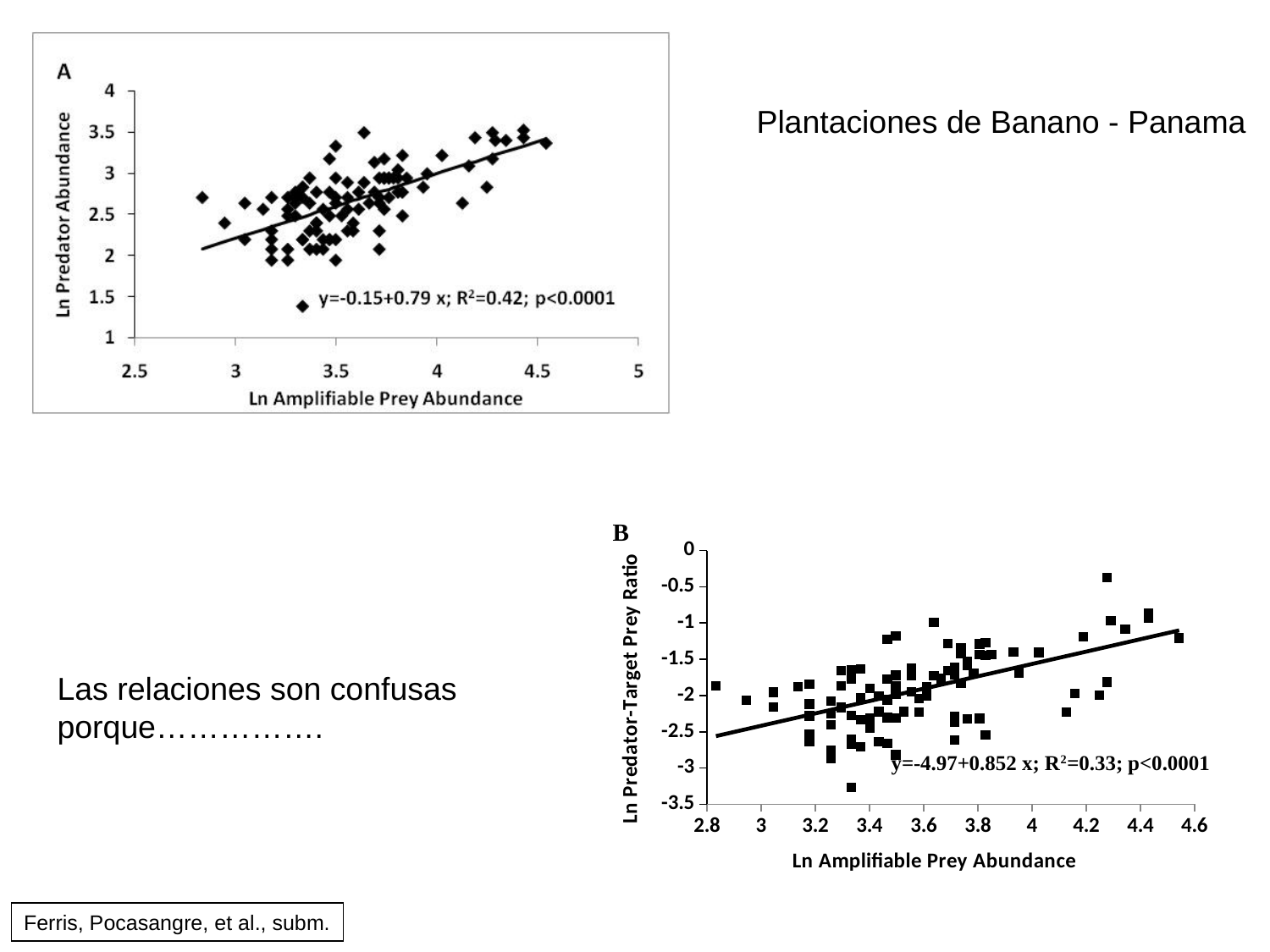
In chart A, is the y value of the lowest plotted point greater or less than 1.5? less What is the y-axis title of chart B? Ln Predator-Target Prey Ratio What kind of chart is chart A (top left)? scatter chart What is the x-axis title of chart A? Ln Amplifiable Prey Abundance In chart A, does Ln Predator Abundance generally rise or fall as Ln Amplifiable Prey Abundance increases? rise What R² value is printed on chart A? 0.42 In chart B, does Ln Predator-Target Prey Ratio generally rise or fall as Ln Amplifiable Prey Abundance increases? rise What R² value is printed on chart B? 0.33 What regression equation is printed on chart A? y=-0.15+0.79 x In chart B, is the y value of the highest plotted point greater or less than -1? greater What kind of chart is chart B (bottom right)? scatter chart What is the slope in the regression equation printed on chart B? 0.852